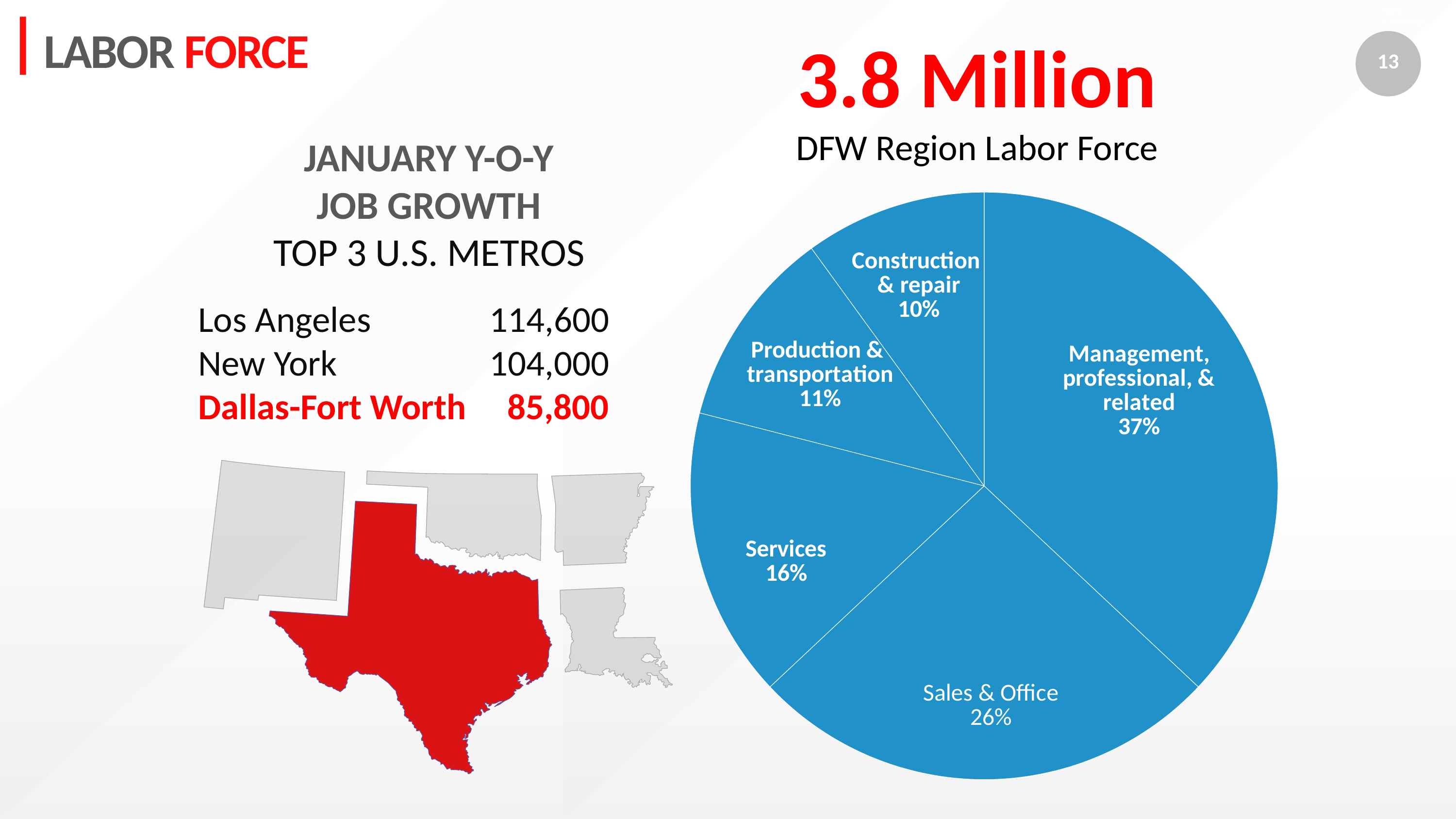
In the DFW Region Labor Force pie chart, what share is Management, professional, & related? 37% Which slice of the DFW Region Labor Force pie chart is the largest? Management, professional, & related In the DFW Region Labor Force pie chart, what share is Sales & Office? 26% What total labor force figure is shown above the DFW Region Labor Force pie chart? 3.8 Million In the DFW Region Labor Force pie chart, what share is Construction & repair? 10% In the DFW Region Labor Force pie chart, what share is Services? 16% Which slice of the DFW Region Labor Force pie chart is the smallest? Construction & repair In the DFW Region Labor Force pie chart, what is the difference in percentage points between Sales & Office and Services? 10 In the DFW Region Labor Force pie chart, which is larger: Services or Production & transportation? Services What type of chart is used to show the DFW Region Labor Force breakdown? pie chart In the DFW Region Labor Force pie chart, what share is Production & transportation? 11% How many slices does the DFW Region Labor Force pie chart have? 5